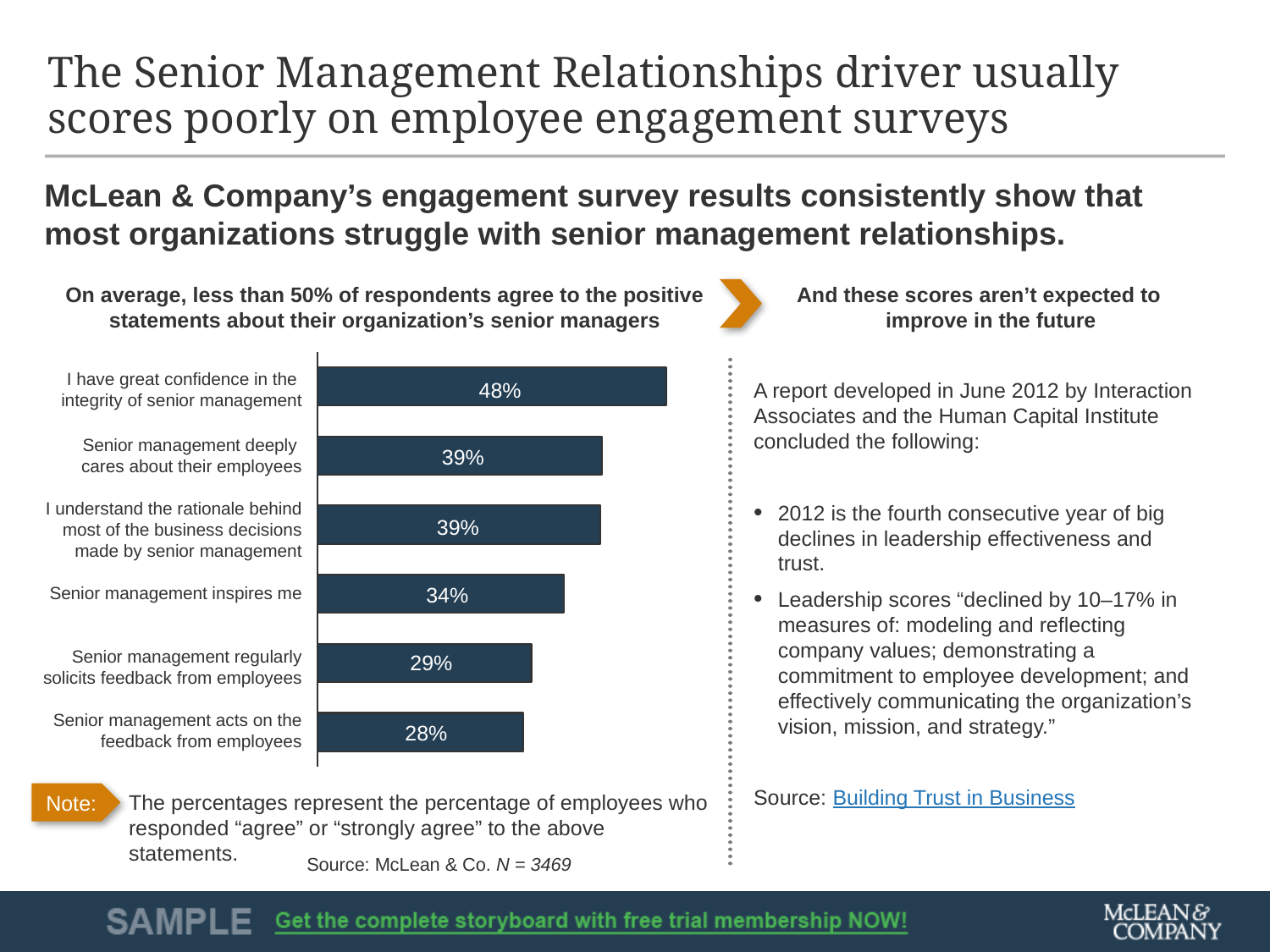
What type of chart is used to show the survey results? Bar chart Do the percentages rise or fall going from the top bar to the bottom bar? Fall Which has a higher agreement percentage: "Senior management inspires me" or "Senior management deeply cares about their employees"? Senior management deeply cares about their employees What percentage of respondents agree that "Senior management acts on the feedback from employees"? 28% What percentage of respondents agree that "Senior management inspires me"? 34% What percentage of respondents agree with the statement "I have great confidence in the integrity of senior management"? 48% What is the difference in percentage points between "I have great confidence in the integrity of senior management" and "Senior management acts on the feedback from employees"? 20 percentage points Which statement has the lowest percentage of agreement? Senior management acts on the feedback from employees What is the sample size (N) given in the source note below the chart? N = 3469 How many statements are shown in the bar chart? 6 Which statement has the highest percentage of agreement? I have great confidence in the integrity of senior management What percentage of respondents agree that "Senior management regularly solicits feedback from employees"? 29%